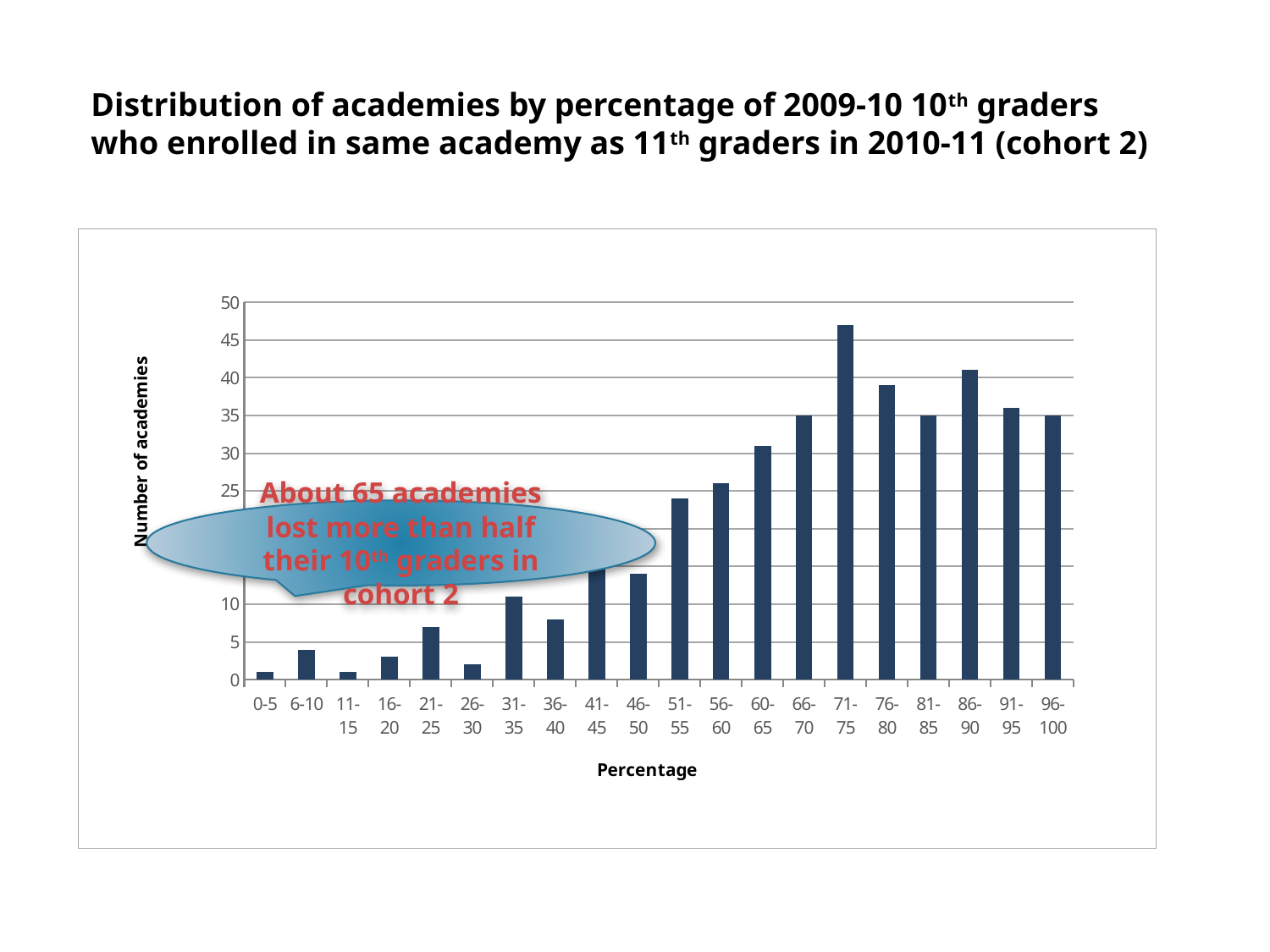
What kind of chart is shown on the slide? bar chart What is the number of academies for the 96-100 category? 35 Do the numbers of academies generally rise or fall as the percentage categories increase along the x axis? rise Is the number of academies for the 71-75 category greater or less than 45? greater Is the number of academies for the 36-40 category greater or less than 10? less Is the number of academies for the 60-65 category greater or less than 30? greater What is the title of the vertical axis? Number of academies What is the number of academies for the 66-70 category? 35 Which percentage category has the highest number of academies? 71-75 How many percentage categories are shown on the x axis? 20 Which has more academies, the 71-75 category or the 86-90 category? 71-75